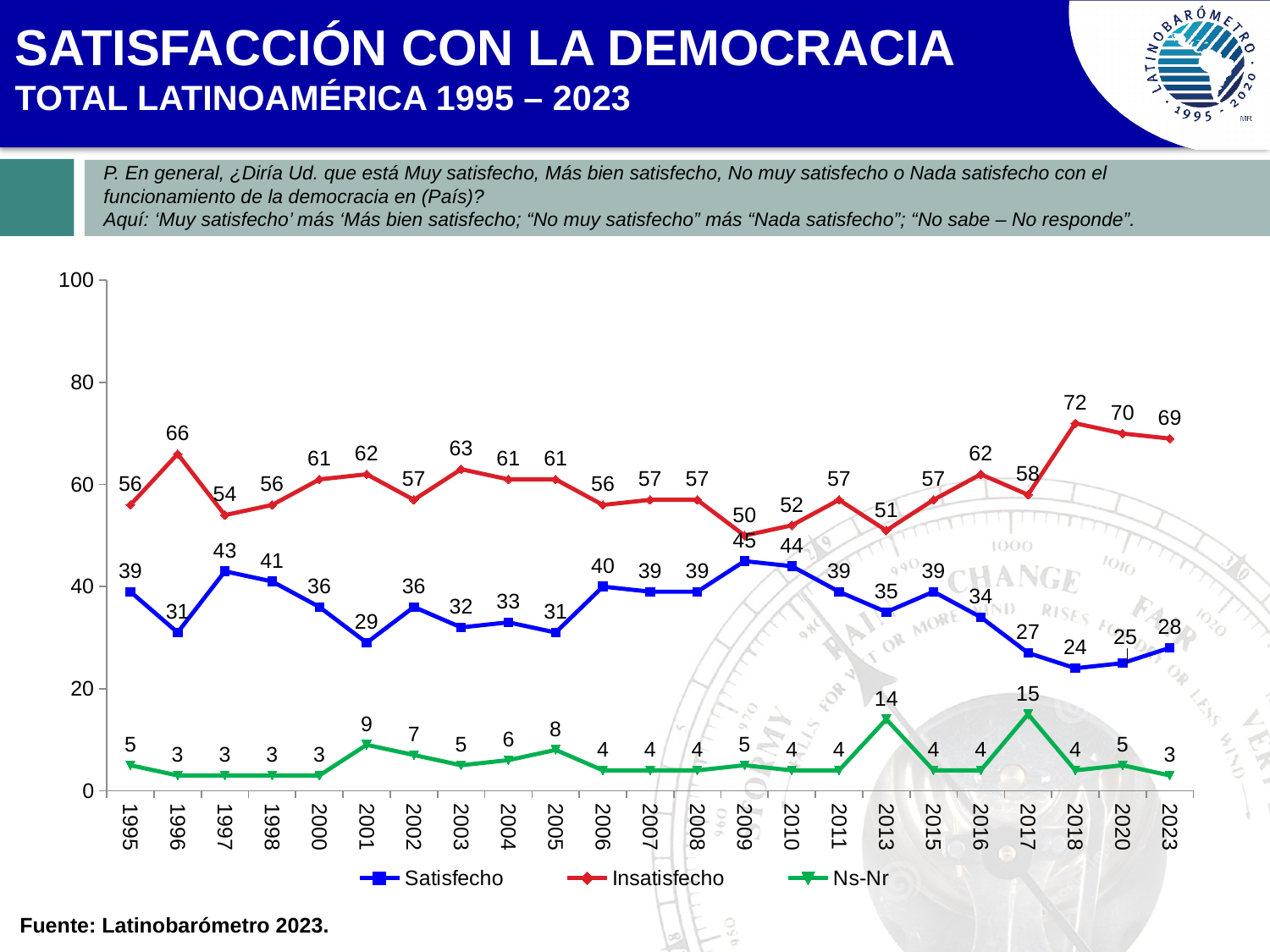
Which is larger in 2009, Satisfecho or Insatisfecho? Insatisfecho What is the value for Ns-Nr in 2017? 15 What kind of chart is shown on the slide? Line chart Does the Satisfecho series rise or fall between 2015 and 2018? Fall In which year does the Satisfecho series reach its highest value? 2009 What is the value for Insatisfecho in 2018? 72 How many years are plotted on the x axis? 23 How many series does the legend list? 3 What is the difference between Insatisfecho and Satisfecho in 2023? 41 What is the value for Satisfecho in 2023? 28 In which year does the Satisfecho series reach its lowest value? 2018 In which year does the Insatisfecho series reach its highest value? 2018